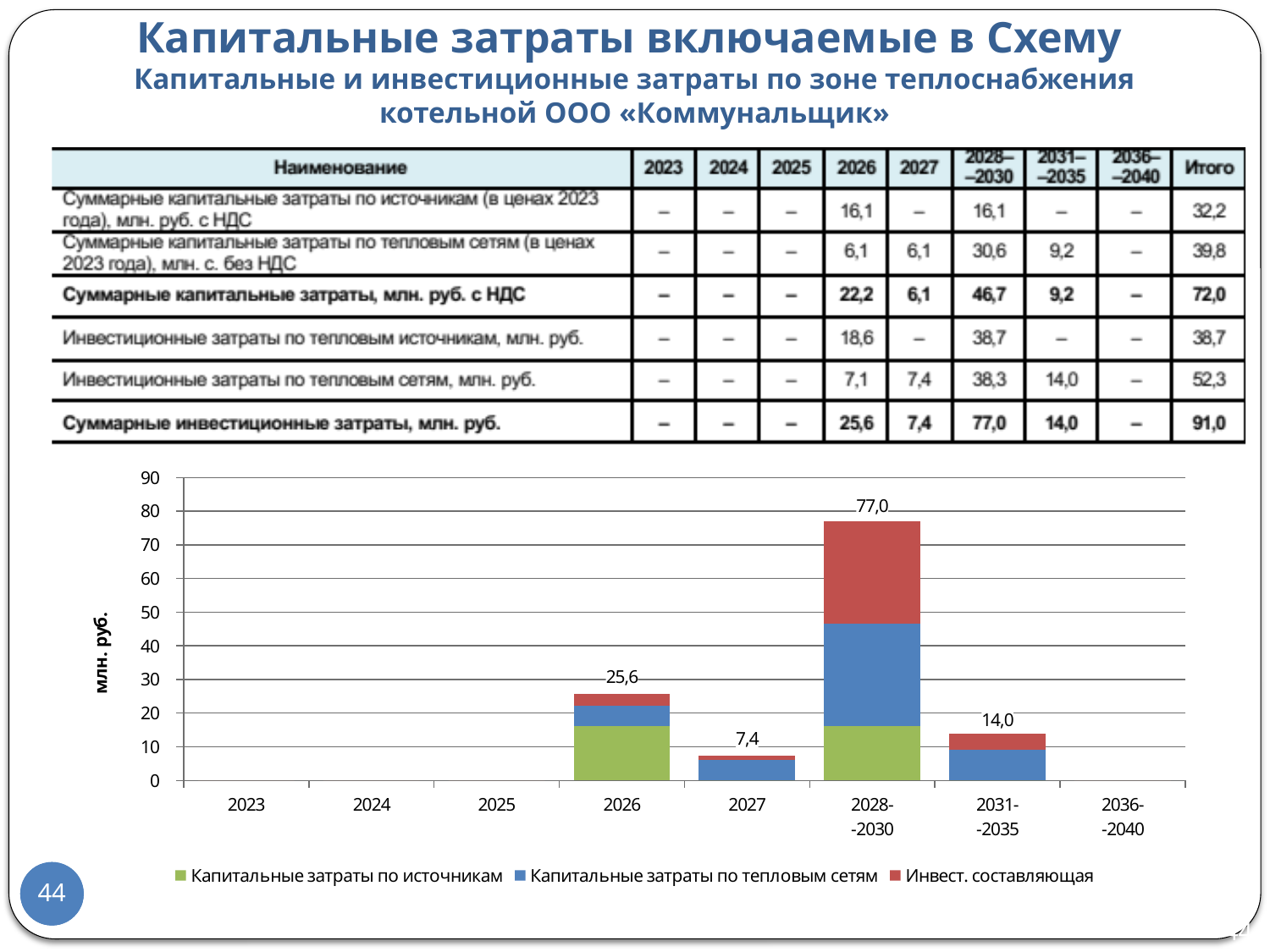
What is the total value labelled on the bar for 2028-2030? 77,0 Which period has the highest total bar in the chart? 2028-2030 How many series does the chart legend list? 3 Is the total bar for 2028-2030 greater or less than 70? greater What kind of chart is shown on the slide? Stacked bar chart How many periods are shown on the x axis of the chart? 8 Among the periods with a labelled bar, which has the lowest total? 2027 What is the total value labelled on the bar for 2026? 25,6 What is the total value labelled on the bar for 2031-2035? 14,0 What is the total value labelled on the bar for 2027? 7,4 What is the difference between the labelled totals for 2028-2030 and 2026? 51,4 Which has the larger labelled total, 2026 or 2031-2035? 2026